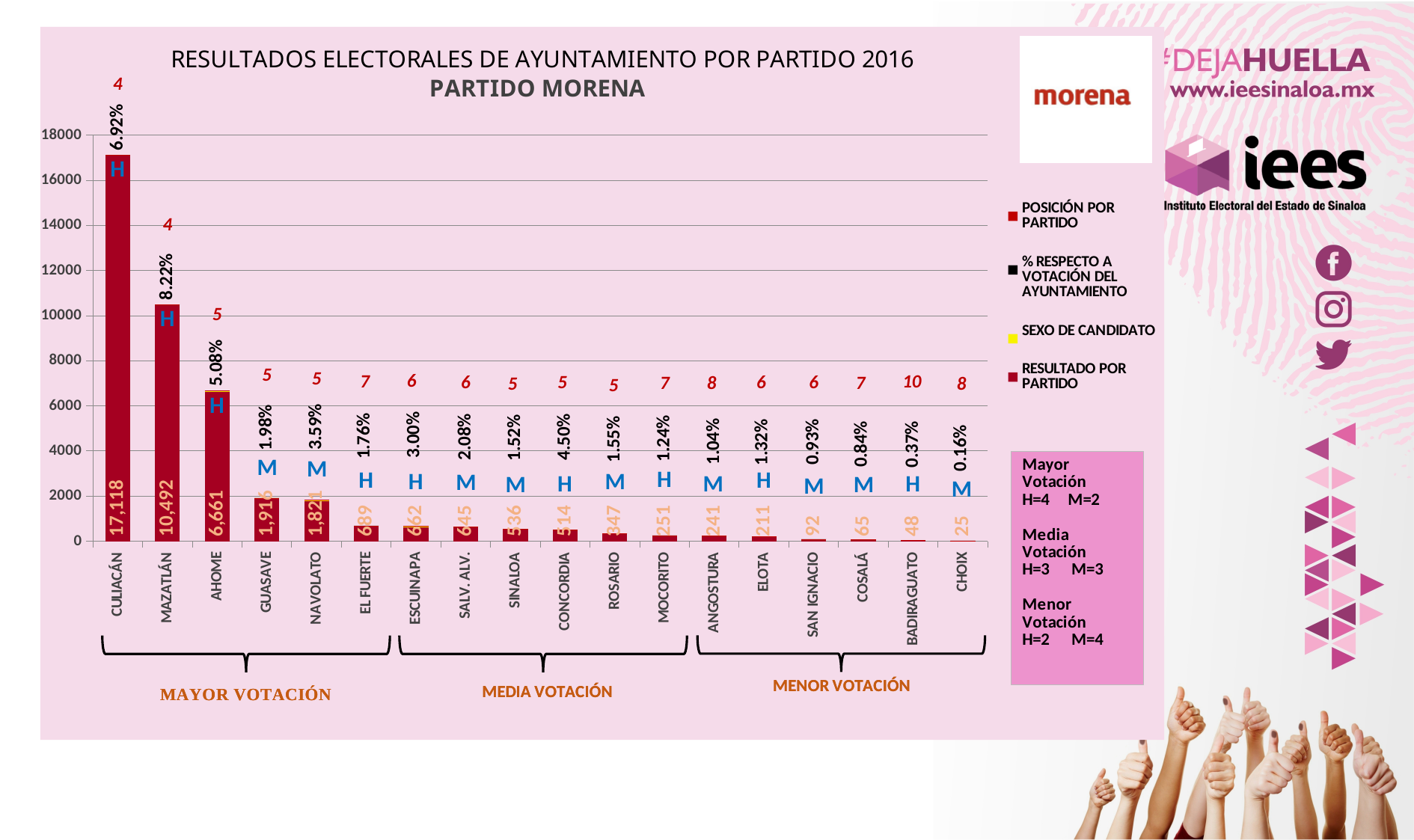
Which municipality has the highest vote result? CULIACÁN Which municipality has the lowest vote result? CHOIX What kind of chart is shown on the slide? bar chart How many municipalities are shown on the x axis? 18 How many entries does the legend list? 4 What percentage with respect to the ayuntamiento vote is shown for MAZATLÁN? 8.22% Is the value for MAZATLÁN greater or less than 10000? greater What is the vote result for CULIACÁN? 17,118 What is the difference between the vote results for CULIACÁN and MAZATLÁN? 6,626 Which has a larger vote result, AHOME or GUASAVE? AHOME What is the vote result for AHOME? 6,661 What is the vote result for MAZATLÁN? 10,492